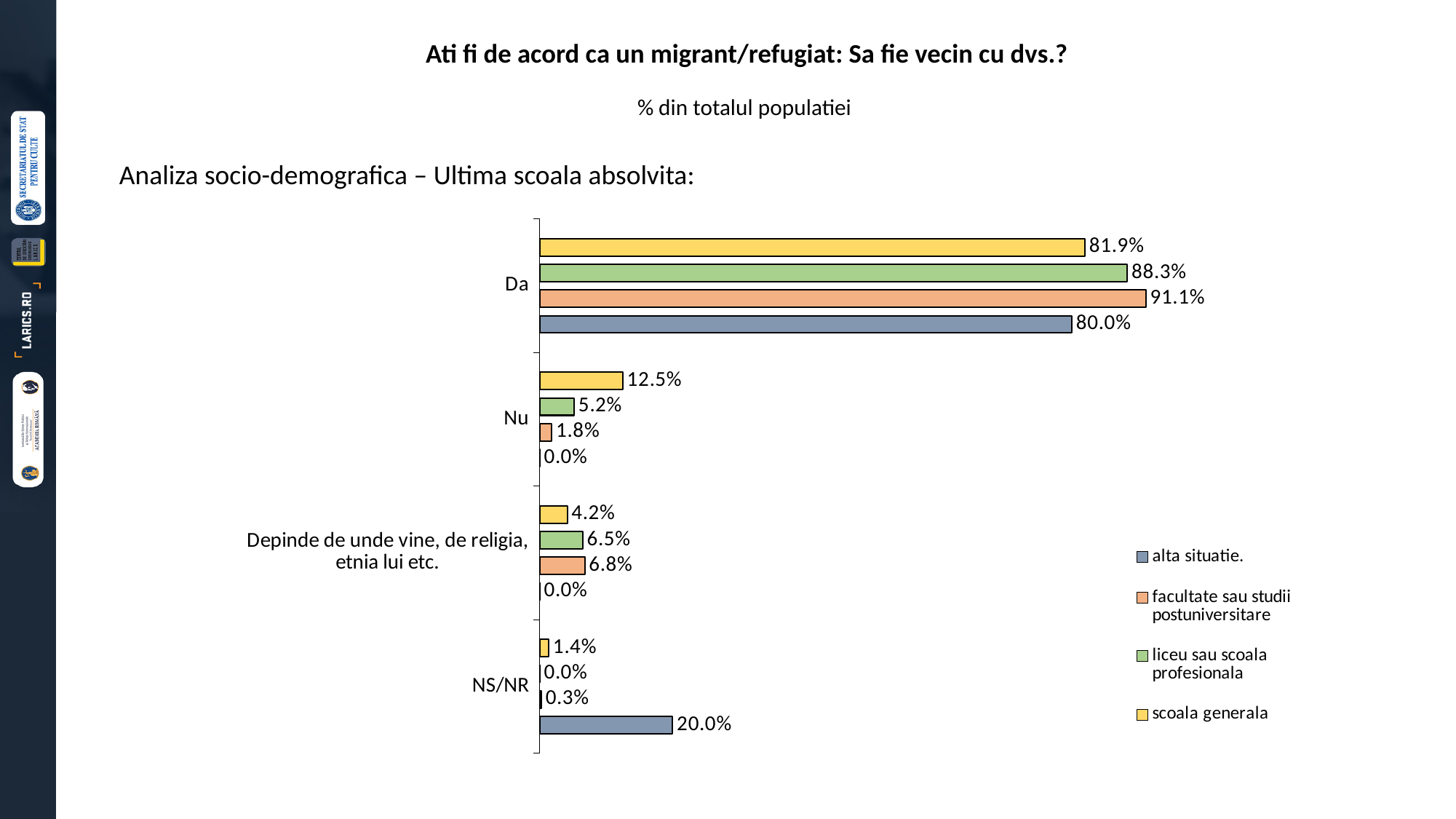
How many series does the legend list? 4 How many response categories are shown on the vertical axis? 4 What is the value for 'facultate sau studii postuniversitare' in the 'Da' category? 91.1% Which series has the highest value in the 'Da' category? facultate sau studii postuniversitare Which series has the lowest value in the 'Da' category? alta situatie. What is the subtitle shown under the chart title? % din totalul populatiei In the 'Nu' category, which is larger: 'scoala generala' or 'liceu sau scoala profesionala'? scoala generala What is the value for 'alta situatie.' in the 'NS/NR' category? 20.0% What is the value for 'scoala generala' in the 'Nu' category? 12.5% What is the value for 'liceu sau scoala profesionala' in the 'Depinde de unde vine, de religia, etnia lui etc.' category? 6.5% What is the difference between 'facultate sau studii postuniversitare' and 'alta situatie.' in the 'Da' category? 11.1% What kind of chart is shown on the slide? bar chart